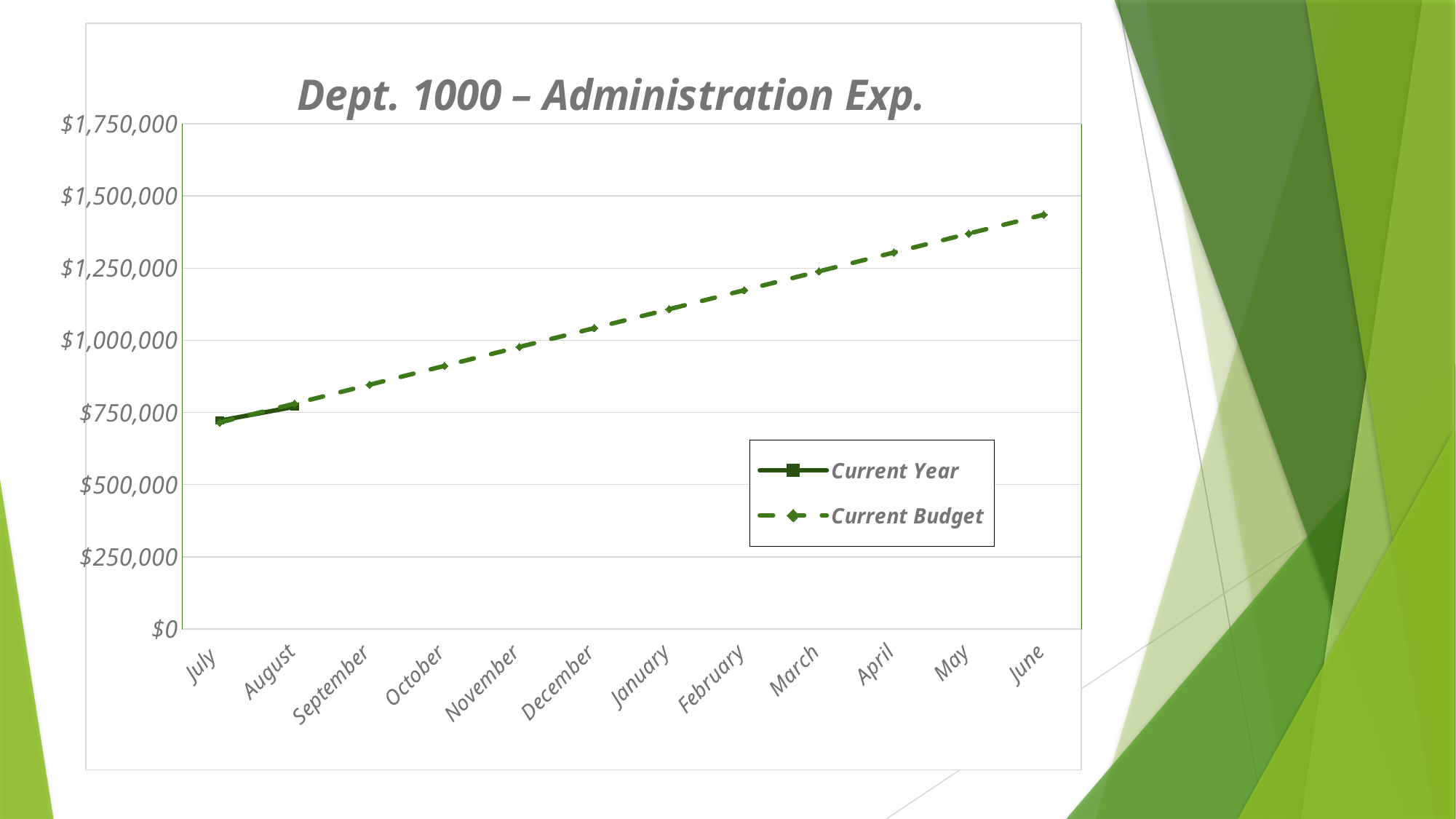
In which month is the Current Budget value highest? June How many series does the legend list? 2 What is the title of the chart? Dept. 1000 – Administration Exp. What kind of chart is shown on the slide? line chart Does the Current Budget series rise or fall from July to June? rise Is the Current Budget value for January greater or less than $1,000,000? greater Is the Current Budget value for May greater or less than $1,500,000? less Is the Current Budget value for June greater or less than $1,250,000? greater How many months are shown along the x axis? 12 Which series is drawn with a dashed line? Current Budget In which month is the Current Budget value lowest? July